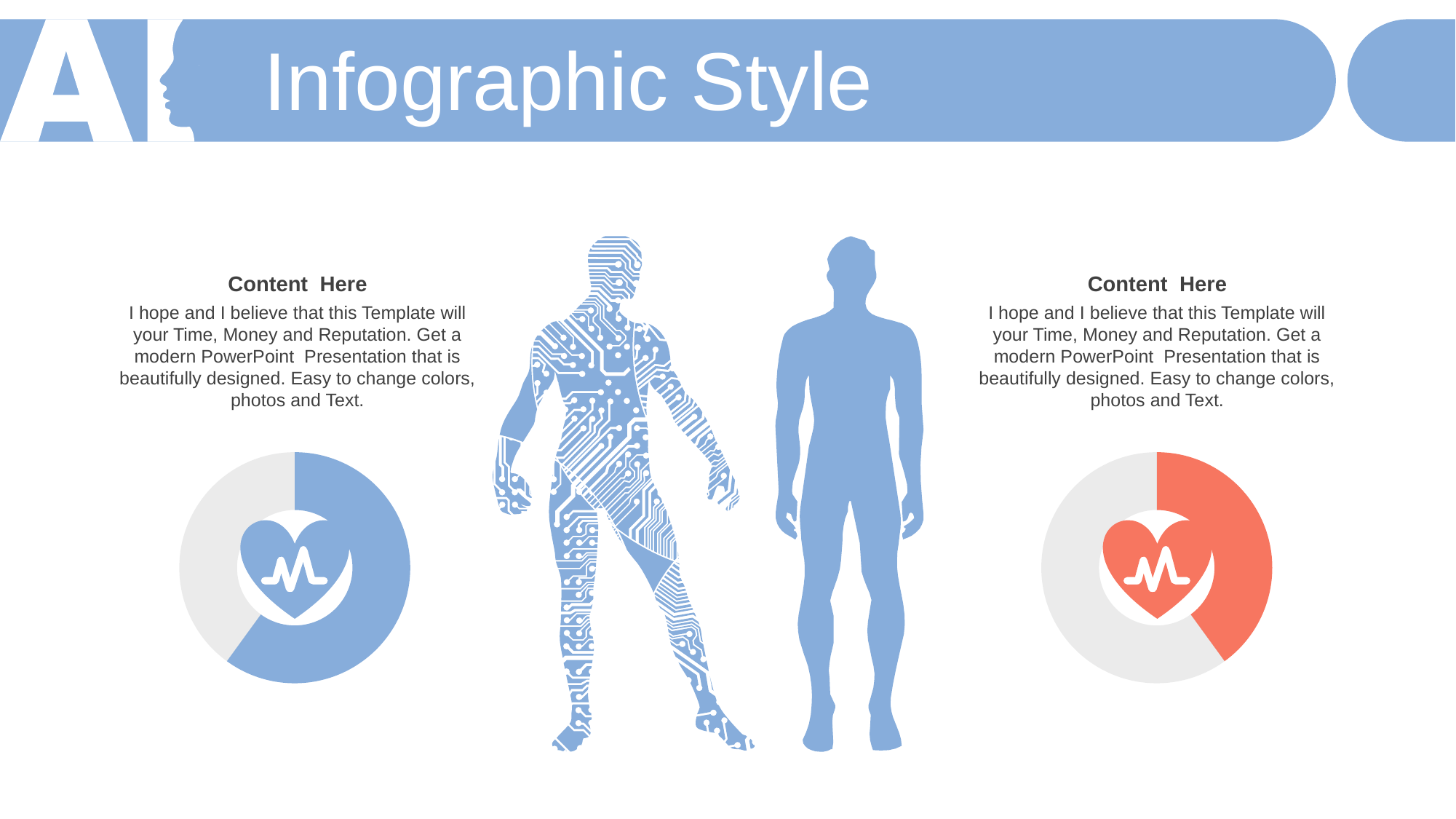
How many slices does the right pie chart have? 2 In the right pie chart, which slice is larger, the red slice or the grey slice? the grey slice How many slices does the left pie chart have? 2 What kind of chart is shown on the left side of the slide? doughnut chart In the left pie chart, which slice is the smallest? the grey slice In the left pie chart, which slice is larger, the blue slice or the grey slice? the blue slice What icon is placed in the centre of each pie chart? a heart with a heartbeat line In the right pie chart, which slice is the largest? the grey slice What colour is the highlighted slice in the right pie chart? red What kind of chart is shown on the right side of the slide? doughnut chart